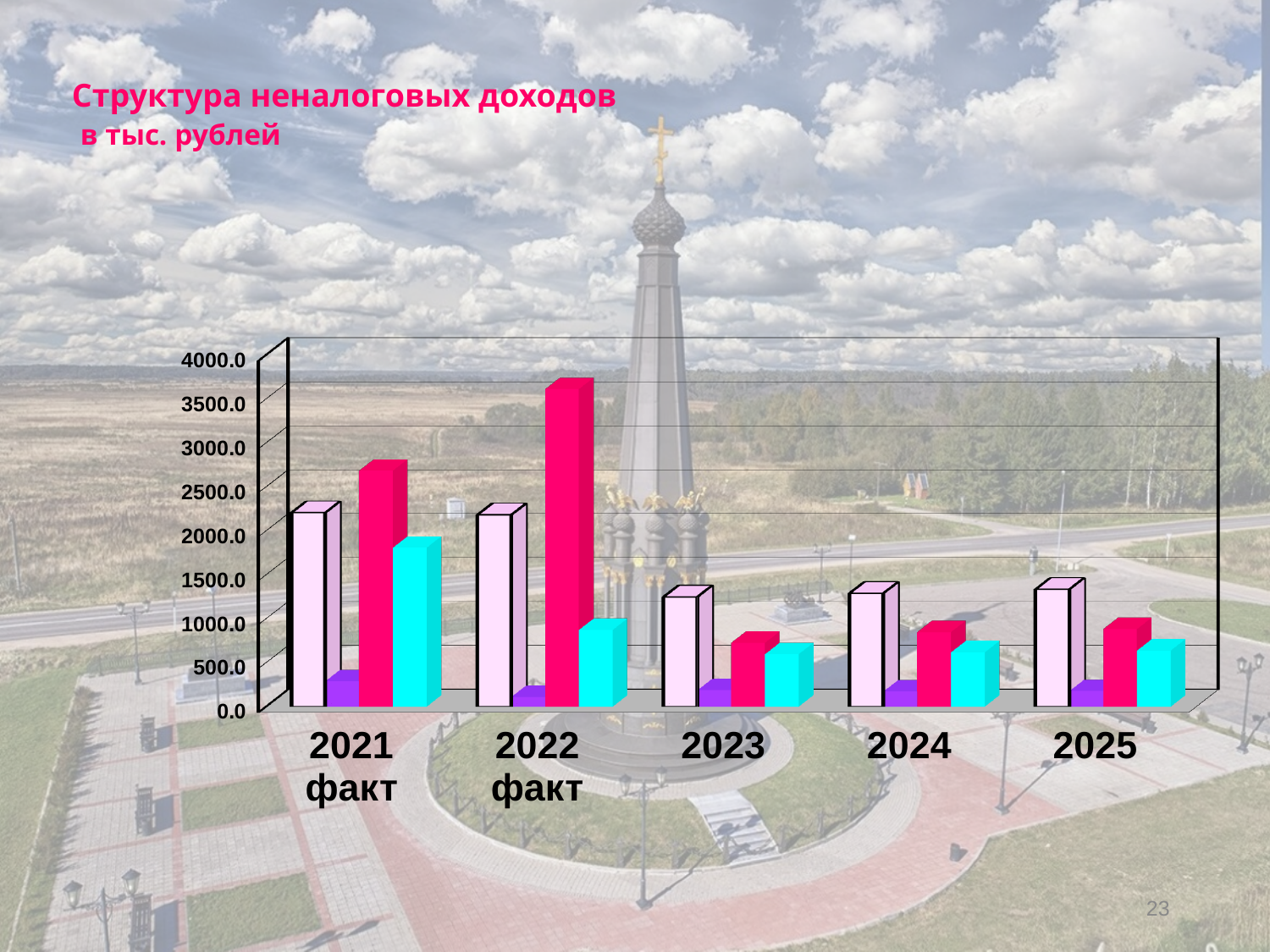
Is the magenta bar for 2021 факт greater or less than 2500.0? greater Is the light pink bar for 2023 greater or less than 1500.0? less How many year categories are shown on the x axis of the chart? 5 Is the magenta bar for 2022 факт greater or less than 3000.0? greater What kind of chart is shown on the slide? bar chart In 2021 факт, which is larger: the magenta bar or the cyan bar? the magenta bar How many bars are plotted for each year category in the chart? 4 What is the title of the chart on the slide? Структура неналоговых доходов в тыс. рублей In which year is the magenta bar the tallest? 2022 факт Which coloured bar is the tallest in the 2023 category? the light pink bar